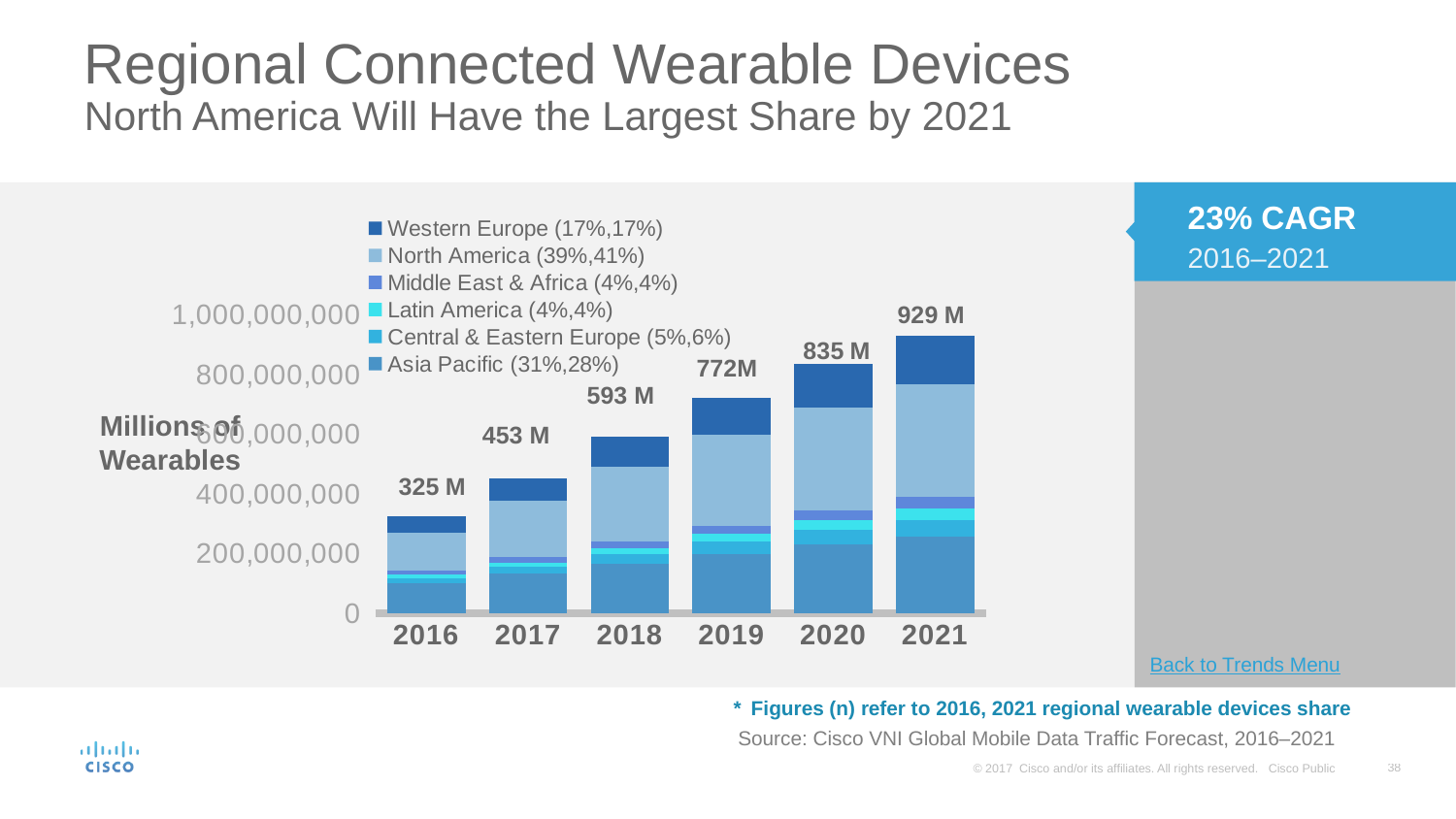
How many series does the legend list? 6 How many years are shown on the x axis? 6 Is the total for 2017 greater or less than 400,000,000? greater What is the total labelled on the bar for 2019? 772M Do the bar totals rise or fall from 2016 to 2021? Rise Which year has the highest total of connected wearable devices? 2021 What kind of chart is shown on the slide? Stacked bar chart What is the total labelled on the bar for 2016? 325 M What is the difference between the totals labelled for 2021 and 2016? 604 M Which year has the lowest total of connected wearable devices? 2016 What is the total labelled on the bar for 2021? 929 M Which is larger, the total for 2018 or the total for 2020? 2020